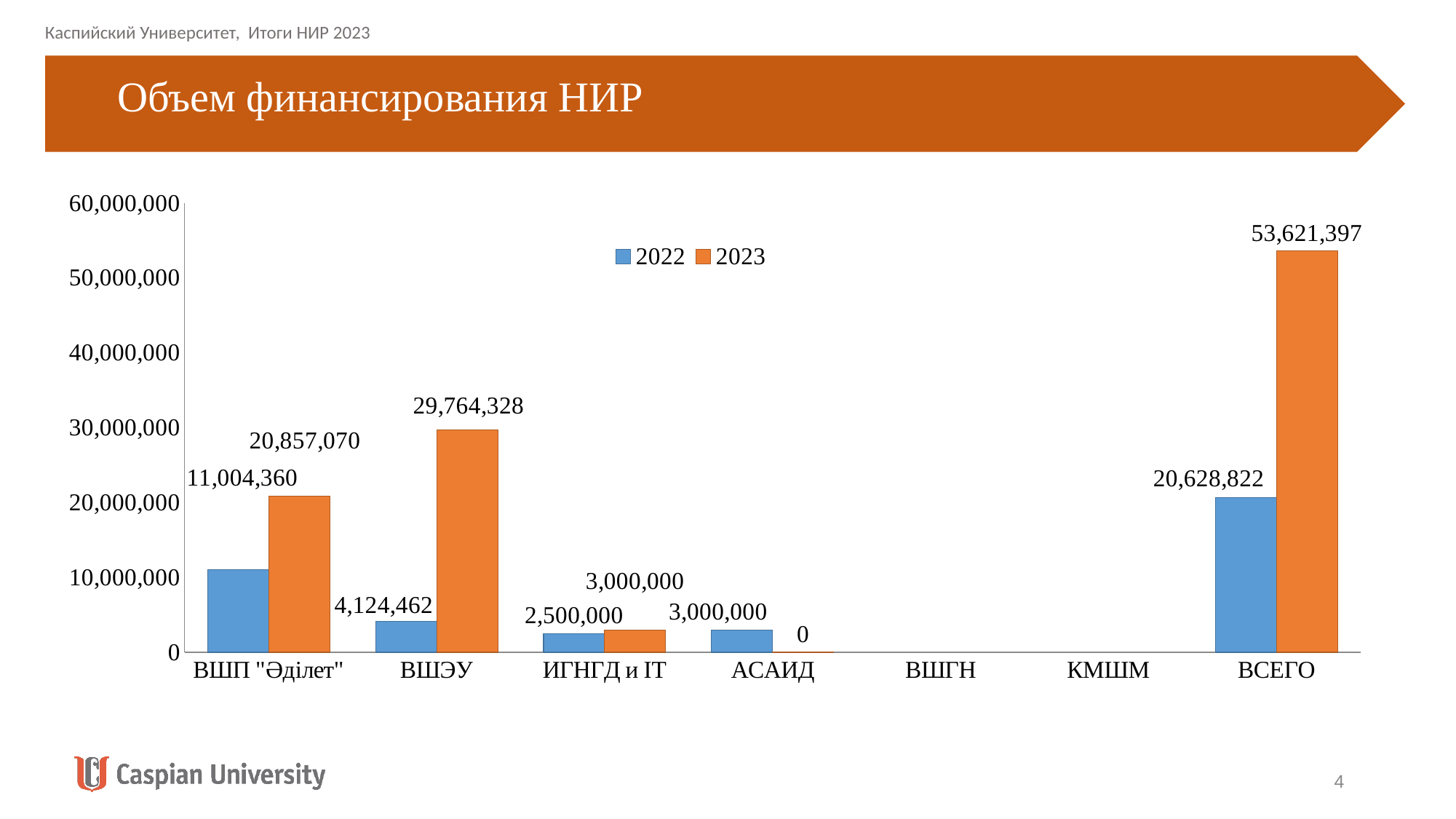
How many categories are shown on the x axis? 7 Which is larger for ИГНГД и IT, the 2022 value or the 2023 value? 2023 What is the difference between the 2023 and 2022 values for ВСЕГО? 32,992,575 What is the 2022 value for ВШП "Әділет"? 11,004,360 Excluding ВСЕГО, which category has the highest 2023 value? ВШЭУ How many series does the legend list? 2 What is the 2023 value for ВСЕГО? 53,621,397 What is the 2023 value for ВШЭУ? 29,764,328 Is the 2023 value for ВШП "Әділет" greater or less than 20,000,000? greater What is the title of the chart? Объем финансирования НИР What is the 2023 value for АСАИД? 0 What type of chart is shown on the slide? bar chart